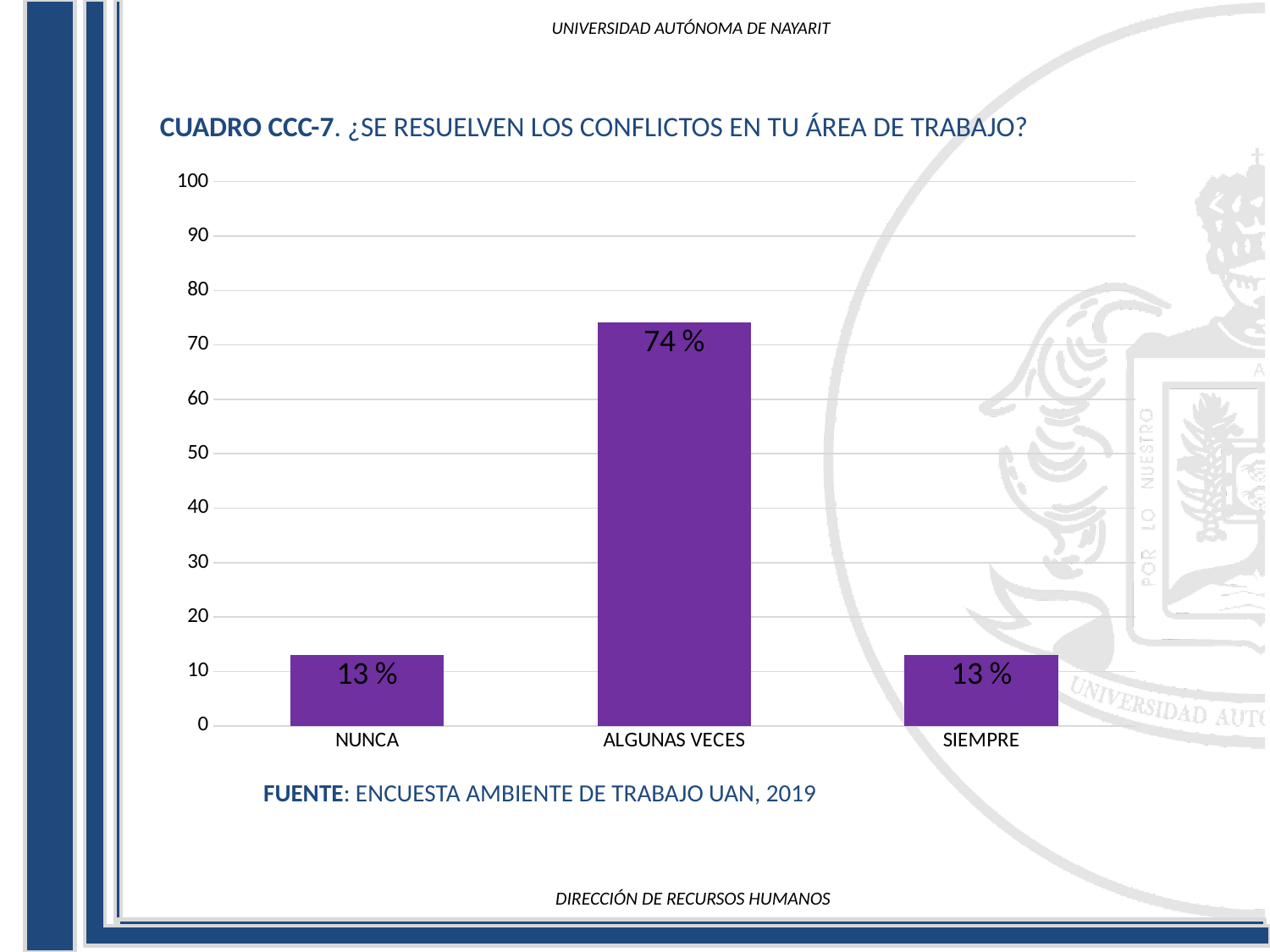
Is the value for NUNCA greater or less than 20? less Which is larger, the value for ALGUNAS VECES or the value for SIEMPRE? ALGUNAS VECES What is the difference between the values for ALGUNAS VECES and NUNCA? 61 % Which category has the highest value? ALGUNAS VECES How many categories are shown on the x axis? 3 What is the title of the chart? CUADRO CCC-7. ¿SE RESUELVEN LOS CONFLICTOS EN TU ÁREA DE TRABAJO? What kind of chart is shown on the slide? bar chart What source is cited below the chart? ENCUESTA AMBIENTE DE TRABAJO UAN, 2019 What is the value for NUNCA? 13 % What is the value for SIEMPRE? 13 % Is the value for ALGUNAS VECES greater or less than 70? greater What is the value for ALGUNAS VECES? 74 %